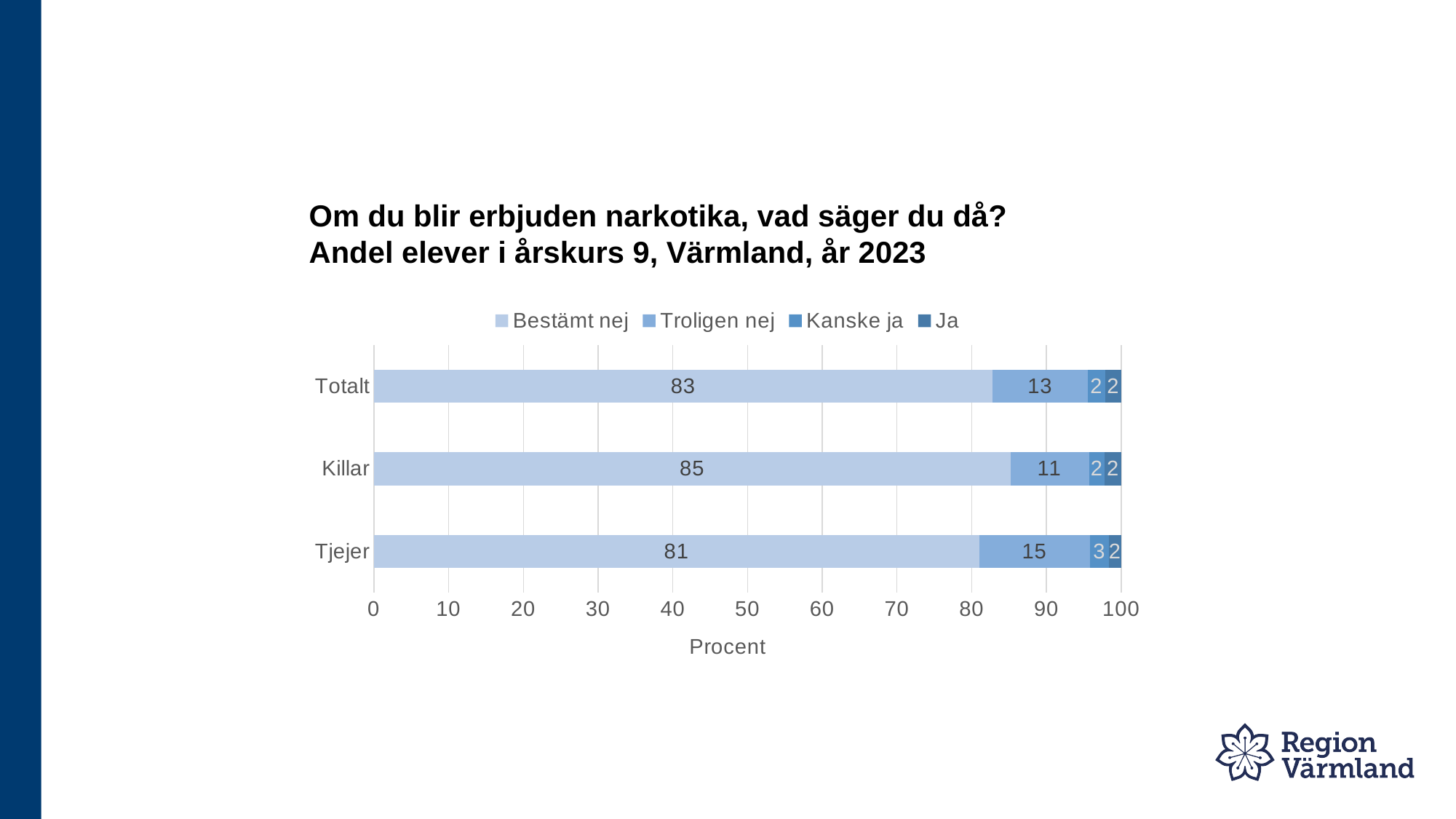
What is the value of "Bestämt nej" for Totalt? 83 How many series does the legend list? 4 What is the value of "Kanske ja" for Tjejer? 3 What kind of chart is shown? Stacked bar chart Which is larger: the "Troligen nej" value for Tjejer or for Killar? Tjejer What is the value of "Troligen nej" for Tjejer? 15 Which category has the highest value for "Bestämt nej"? Killar What is the label of the x axis? Procent What is the difference between the "Bestämt nej" values for Killar and Tjejer? 4 Which category has the lowest value for "Bestämt nej"? Tjejer What is the value of "Troligen nej" for Killar? 11 How many categories are shown on the y axis? 3